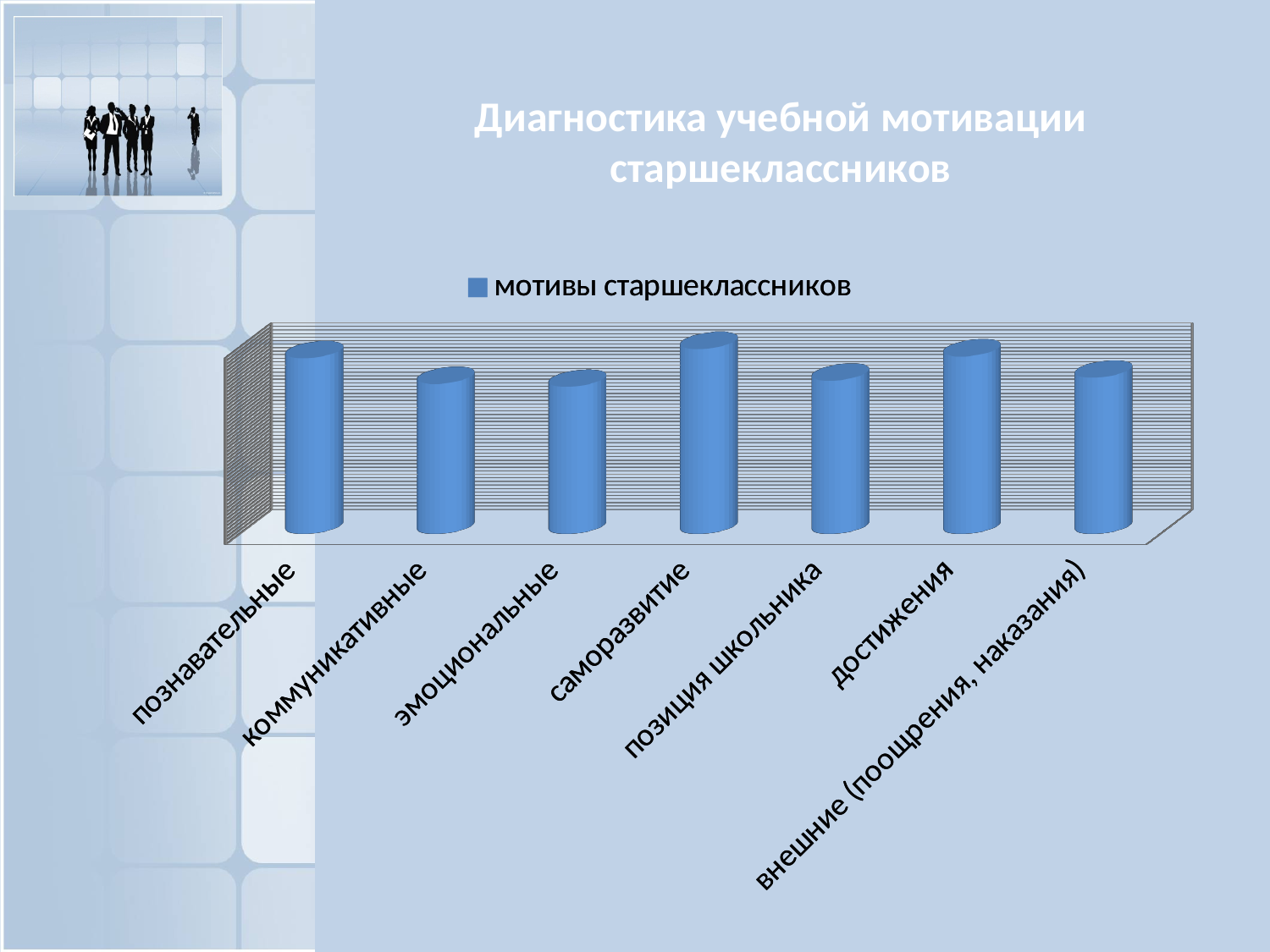
What is the title of the slide containing the chart? Диагностика учебной мотивации старшеклассников How many categories are shown on the x axis of the chart? 7 Which bar is taller: саморазвитие or эмоциональные? саморазвитие Which bar is taller: саморазвитие or внешние (поощрения, наказания)? саморазвитие Which bar is taller: познавательные or коммуникативные? познавательные How many series does the chart legend list? 1 What kind of chart is shown on the slide? bar chart What is the name of the series shown in the chart legend? мотивы старшеклассников Which category has the highest bar in the chart? саморазвитие